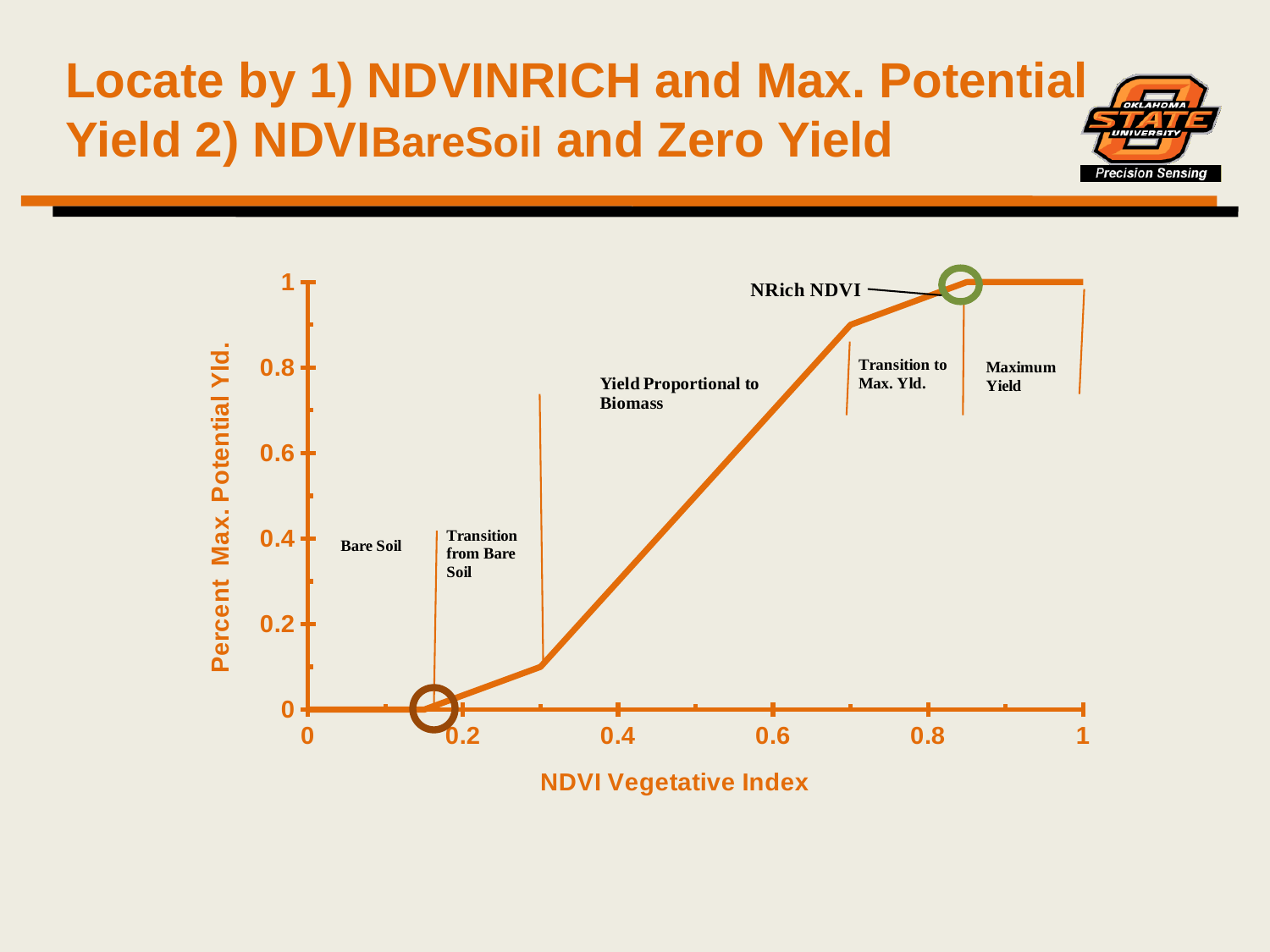
What is the Percent Max. Potential Yld. value when the NDVI Vegetative Index is 0? 0 Is the Percent Max. Potential Yld. at an NDVI of 0.8 greater or less than 0.8? greater What is the highest Percent Max. Potential Yld. value reached by the line? 1 What is the Percent Max. Potential Yld. value when the NDVI Vegetative Index is 1? 1 What label is attached to the green circle near the top of the line? NRich NDVI Is the Percent Max. Potential Yld. at an NDVI of 0.4 greater or less than 0.6? less What is the title of the x axis? NDVI Vegetative Index Does the Percent Max. Potential Yld. rise or fall as the NDVI Vegetative Index increases from 0.3 to 0.7? rise Which is larger, the Percent Max. Potential Yld. at an NDVI of 0.2 or at an NDVI of 0.6? 0.6 What kind of chart is shown on the slide? line chart Is the Percent Max. Potential Yld. at an NDVI of 0.6 greater or less than 0.4? greater What is the lowest Percent Max. Potential Yld. value on the line? 0